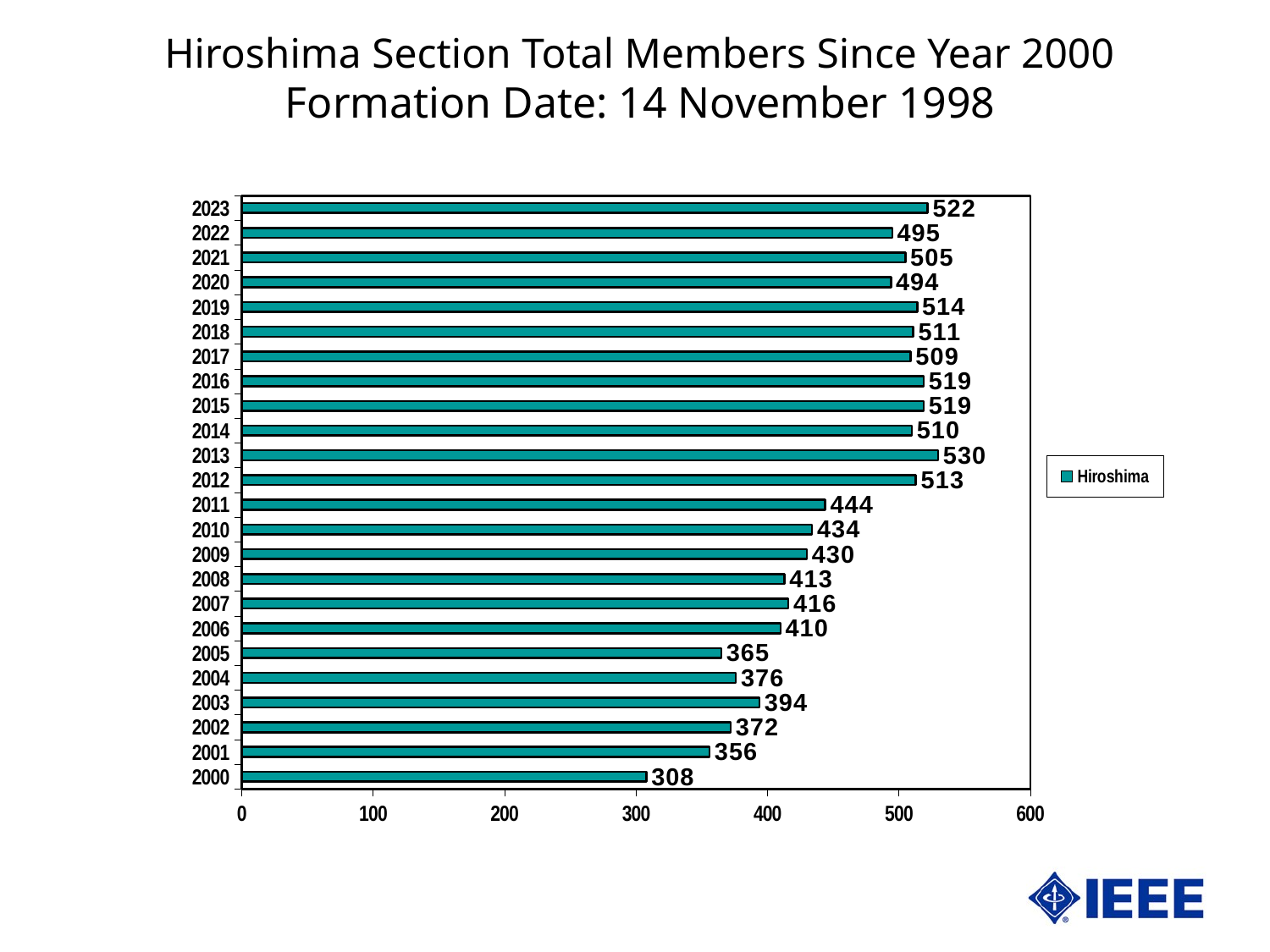
Which year has the lowest value? 2000 What kind of chart is shown? bar chart What is the difference between the values for 2023 and 2000? 214 How many series does the legend list? 1 Which is larger, the value for 2005 or the value for 2004? 2004 Is the value for 2012 greater or less than 500? greater What is the value for 2023? 522 What is the value for 2011? 444 What series name is shown in the legend? Hiroshima Which year has the highest value? 2013 How many years are shown on the chart? 24 What is the value for 2000? 308